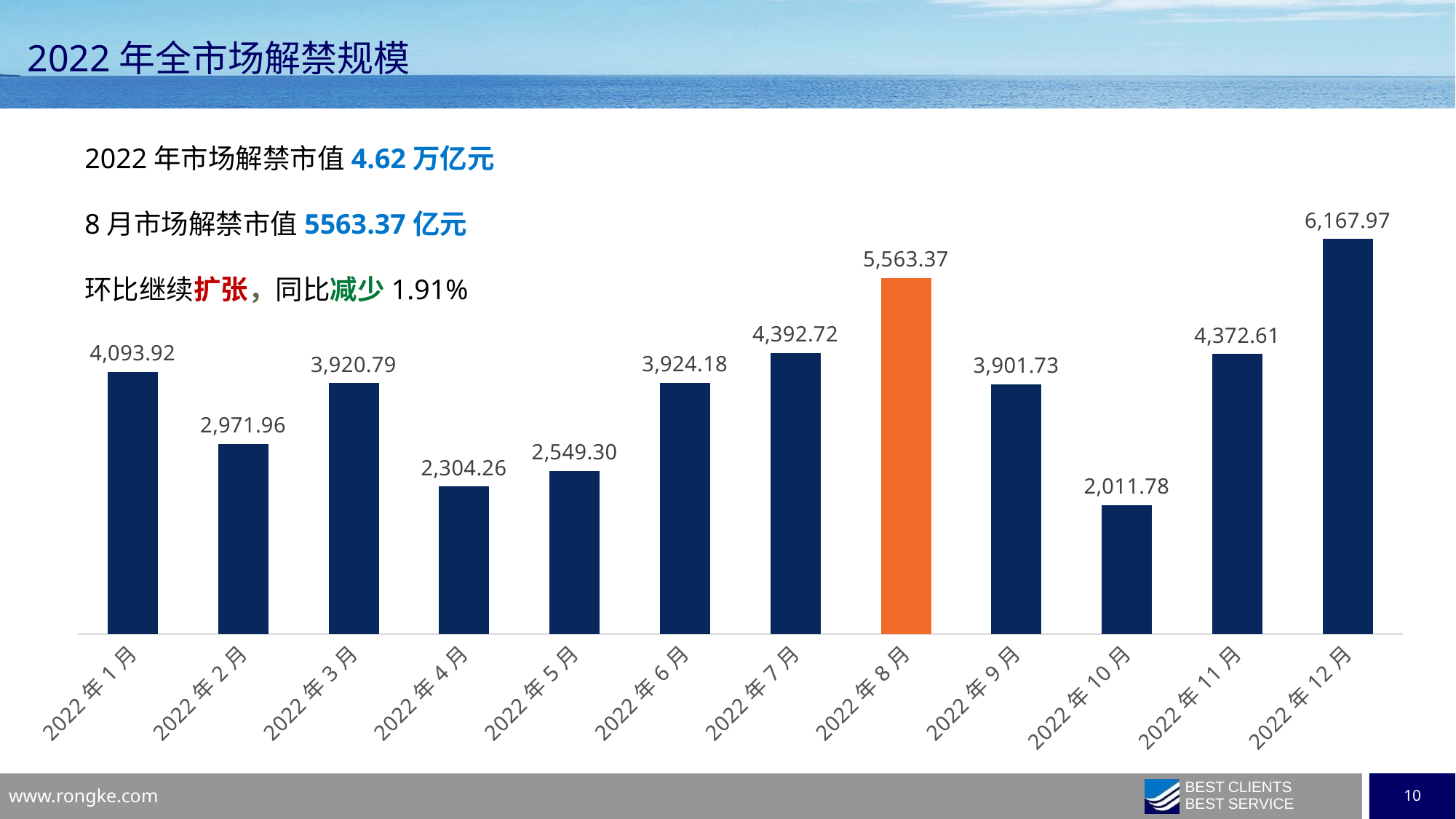
Which is larger, the value for 2022年5月 or 2022年9月? 2022年9月 What is the value for 2022年11月? 4,372.61 Which bar is highlighted in orange? 2022年8月 What is the difference between the values for 2022年8月 and 2022年7月? 1,170.65 What is the value for 2022年4月? 2,304.26 Which month has the lowest value? 2022年10月 What is the difference between the values for 2022年12月 and 2022年8月? 604.60 Which month has the highest value? 2022年12月 What kind of chart is shown on the slide? bar chart How many months are shown on the x axis? 12 Which is larger, the value for 2022年1月 or 2022年2月? 2022年1月 What is the value for 2022年8月? 5,563.37